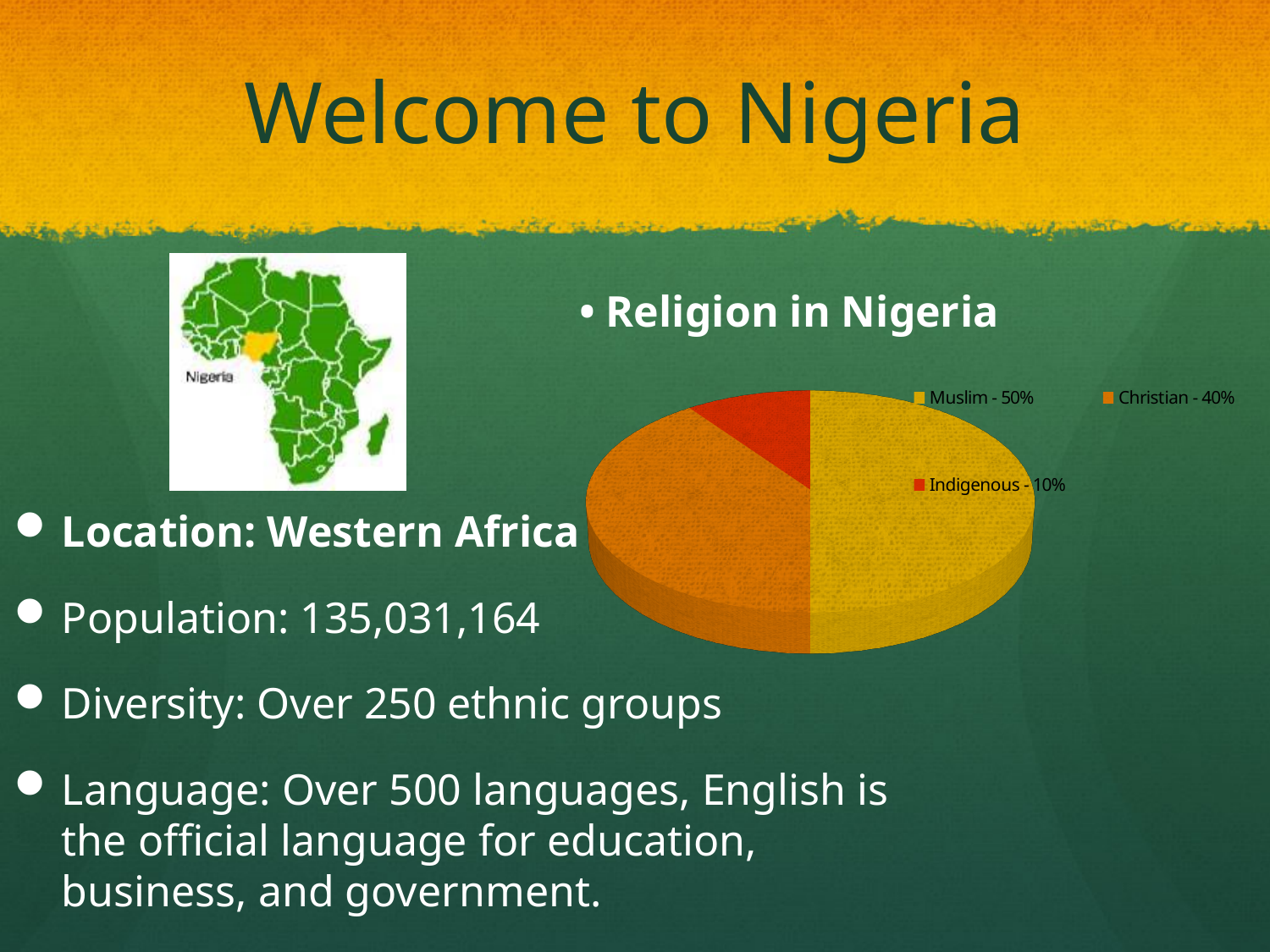
Which is larger, the Christian slice or the Indigenous slice? Christian How many slices does the pie chart have? 3 What share of the pie does the Muslim slice represent? 50% What is the difference in percentage points between the Muslim and Christian slices? 10 What colour is the Indigenous slice of the pie? Red Which religion has the smallest slice of the pie? Indigenous What share of the pie does the Indigenous slice represent? 10% What is the title shown above the pie chart? Religion in Nigeria Which religion has the largest slice of the pie? Muslim What kind of chart is shown on the slide? Pie chart What share of the pie does the Christian slice represent? 40% How many entries does the legend list? 3